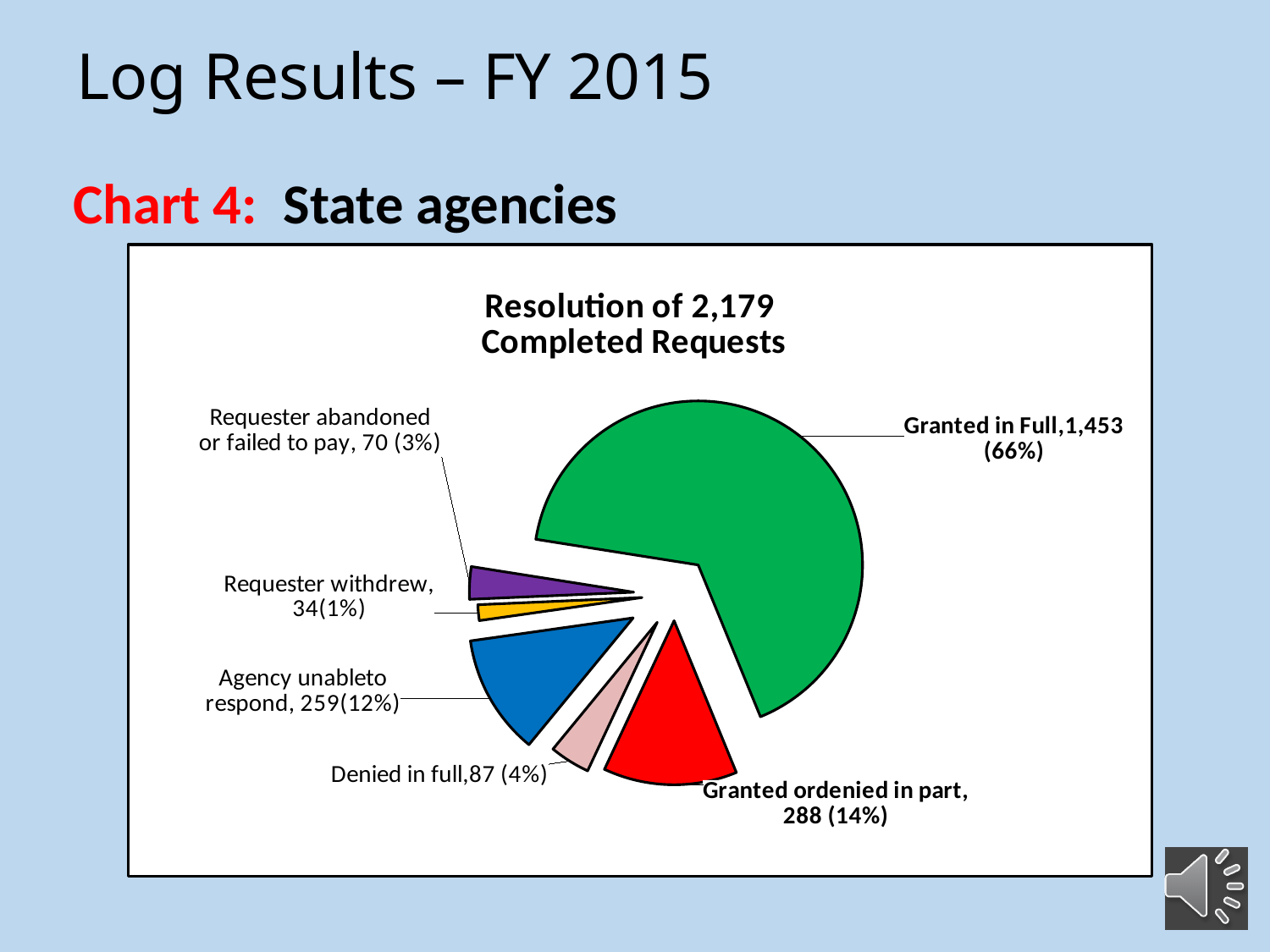
How many requests were Denied in full? 87 Which category has the largest slice of the pie? Granted in Full Which is larger: the number of requests where the Requester abandoned or failed to pay, or the number where the Requester withdrew? Requester abandoned or failed to pay What is the title of the chart? Resolution of 2,179 Completed Requests What share of completed requests does Agency unable to respond represent? 12% What kind of chart is shown on the slide? Pie chart How many slices does the pie chart have? 6 What share of completed requests were Granted in Full? 66% What is the difference between the number of requests Granted or denied in part and the number where the Agency was unable to respond? 29 Which category has the smallest slice of the pie? Requester withdrew How many requests were Granted in Full? 1,453 How many requests were Granted or denied in part? 288